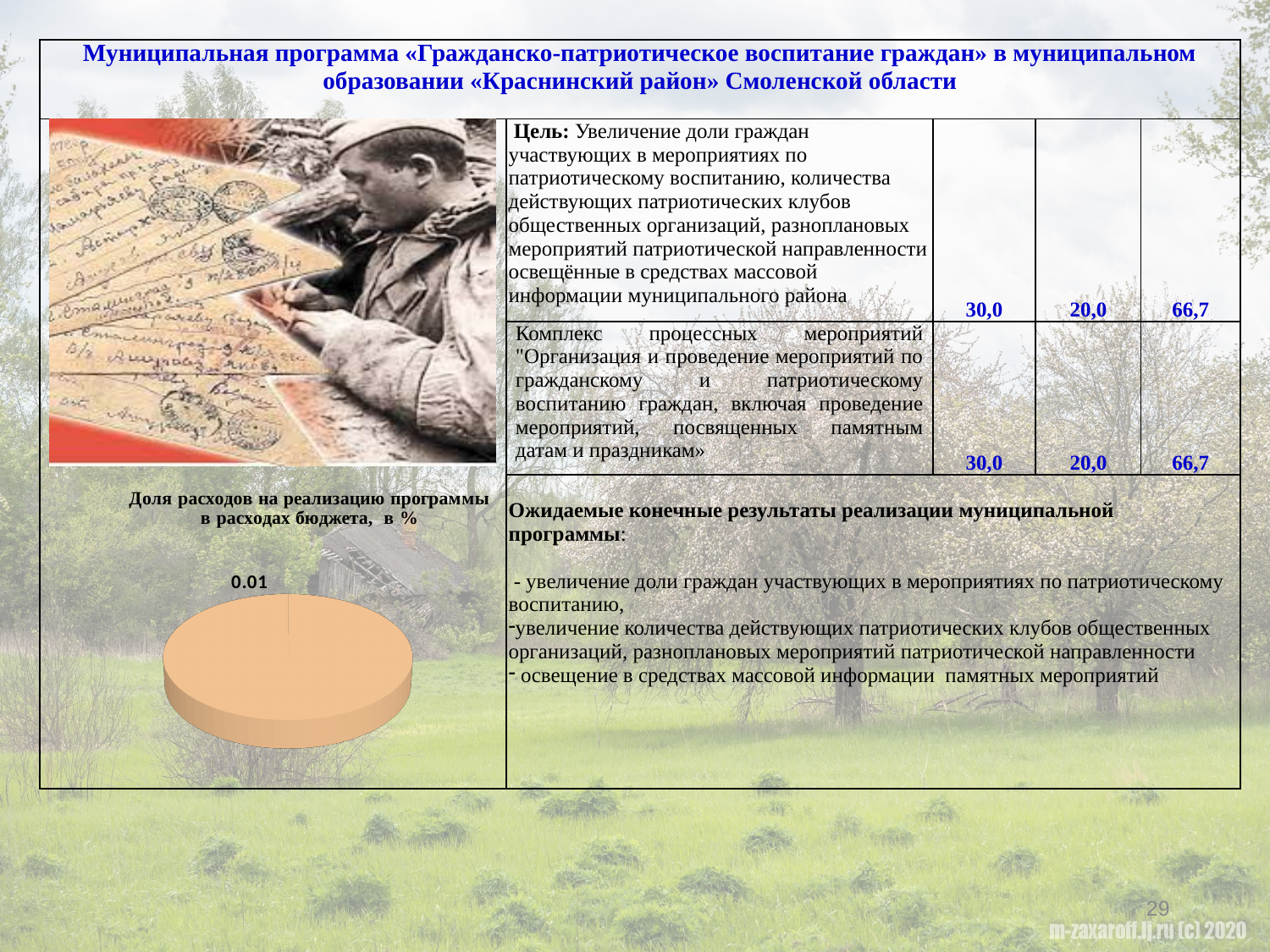
What kind of chart is shown on the slide? pie chart What value is printed as the data label on the pie chart? 0.01 What is the title of the pie chart? Доля расходов на реализацию программы в расходах бюджета, в % Is the value shown on the pie chart greater or less than 1? less